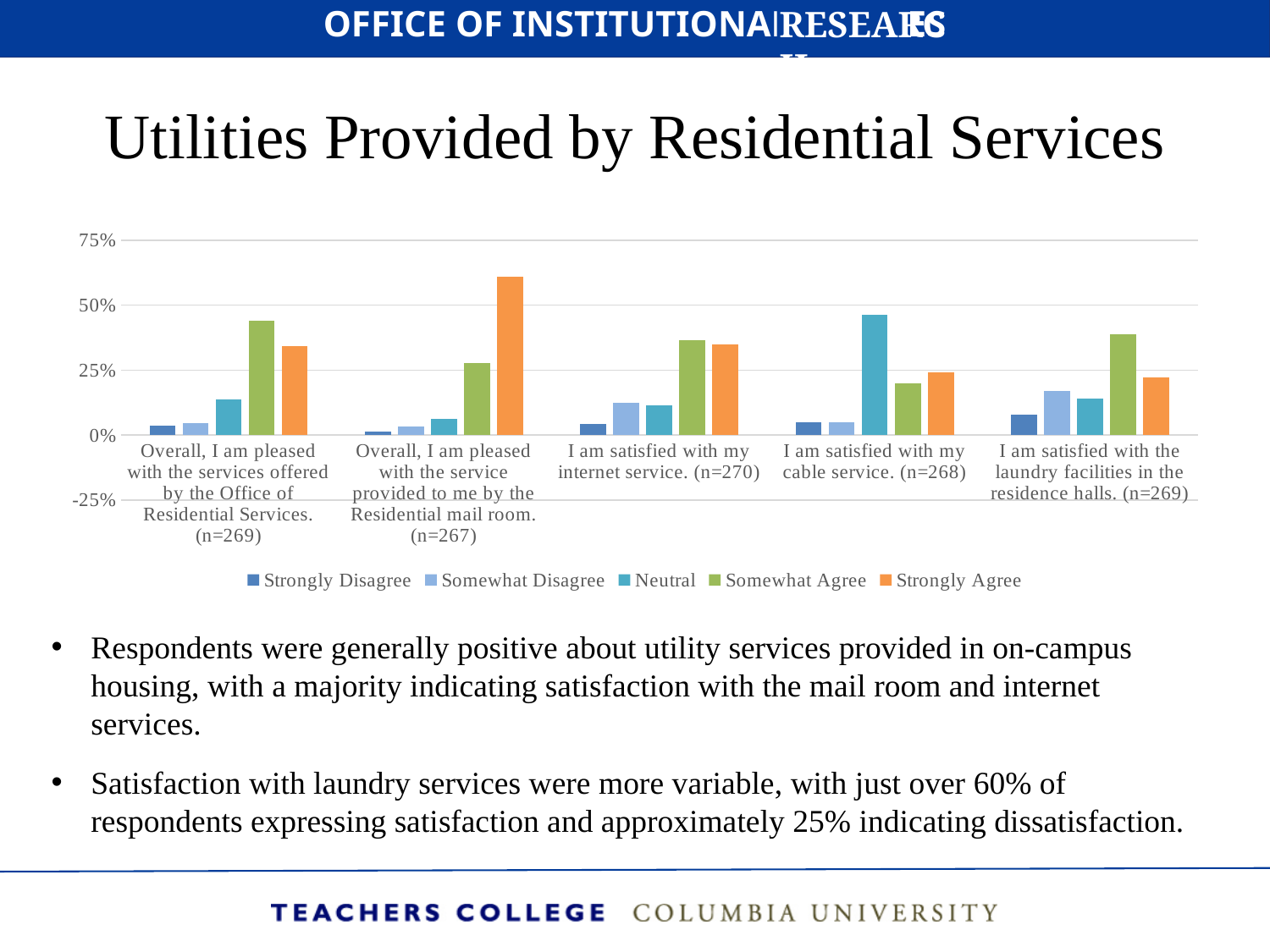
What kind of chart is shown on the slide? Bar chart How many survey statements (categories) are shown along the x axis of the chart? 5 Is the Somewhat Agree value for "Overall, I am pleased with the services offered by the Office of Residential Services." greater or less than 50%? less For "Overall, I am pleased with the services offered by the Office of Residential Services.", which is larger: Somewhat Agree or Strongly Agree? Somewhat Agree Is the Neutral value for "I am satisfied with my cable service." greater or less than 25%? greater What is the title of the chart on the slide? Utilities Provided by Residential Services Which response series has the tallest bar for "Overall, I am pleased with the service provided to me by the Residential mail room."? Strongly Agree Across the five statements, which one has the highest Strongly Agree value? Overall, I am pleased with the service provided to me by the Residential mail room. (n=267) Which response series has the tallest bar for "I am satisfied with my cable service."? Neutral How many series does the chart's legend list? 5 Is the Strongly Agree value for "Overall, I am pleased with the service provided to me by the Residential mail room." greater or less than 50%? greater Which response series has the shortest bar for "Overall, I am pleased with the service provided to me by the Residential mail room."? Strongly Disagree